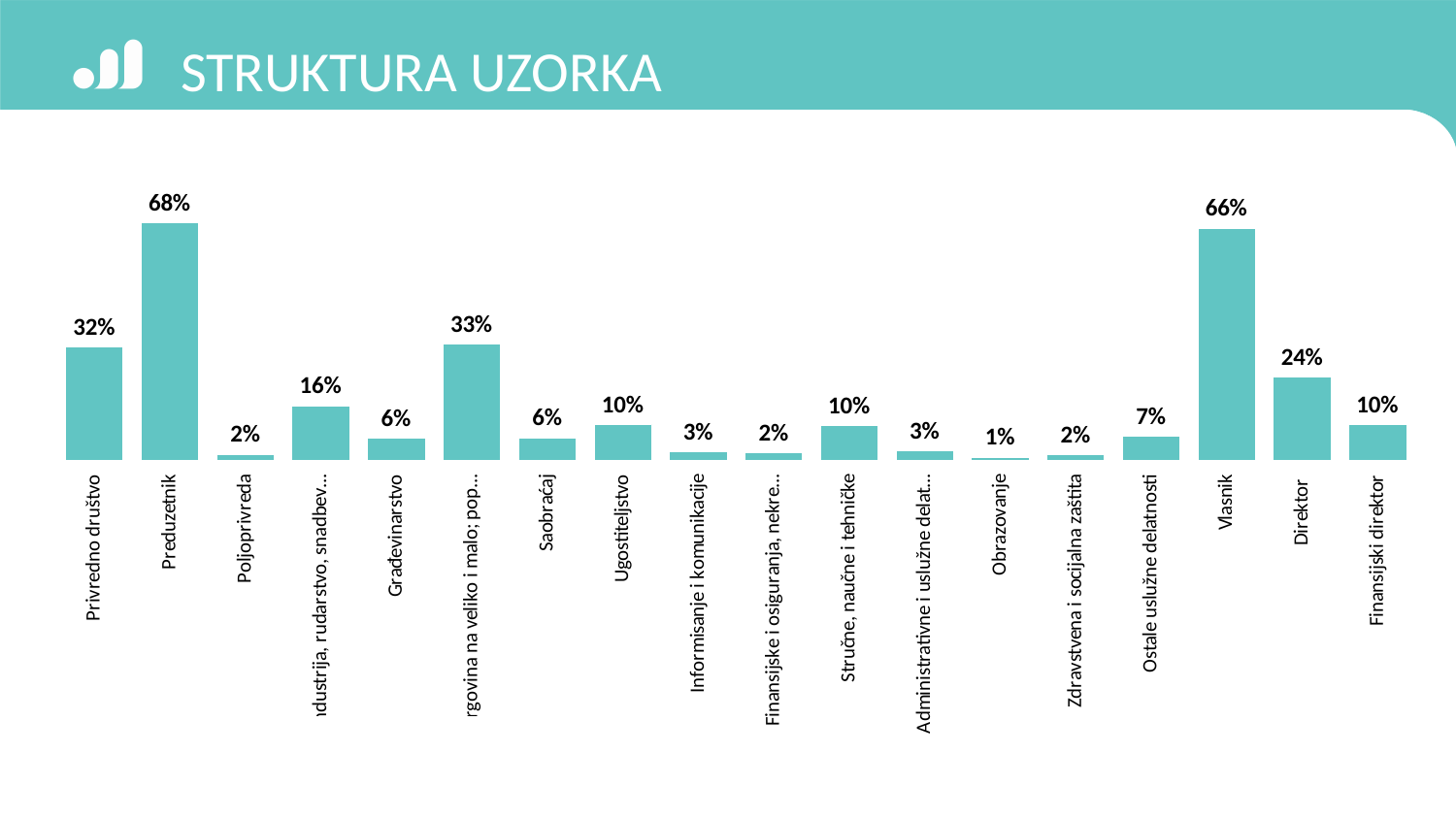
Which is larger, the value for Ugostiteljstvo or the value for Građevinarstvo? Ugostiteljstvo What is the value for Privredno društvo? 32% Which category has the lowest value? Obrazovanje What is the value for Ostale uslužne delatnosti? 7% What is the value for Preduzetnik? 68% What is the difference between the values for Vlasnik and Direktor? 42% What is the value for Direktor? 24% What is the value for Vlasnik? 66% Which category has the highest value? Preduzetnik What is the difference between the values for Preduzetnik and Privredno društvo? 36% What kind of chart is shown on the slide? Bar chart How many bars are shown in the chart? 18